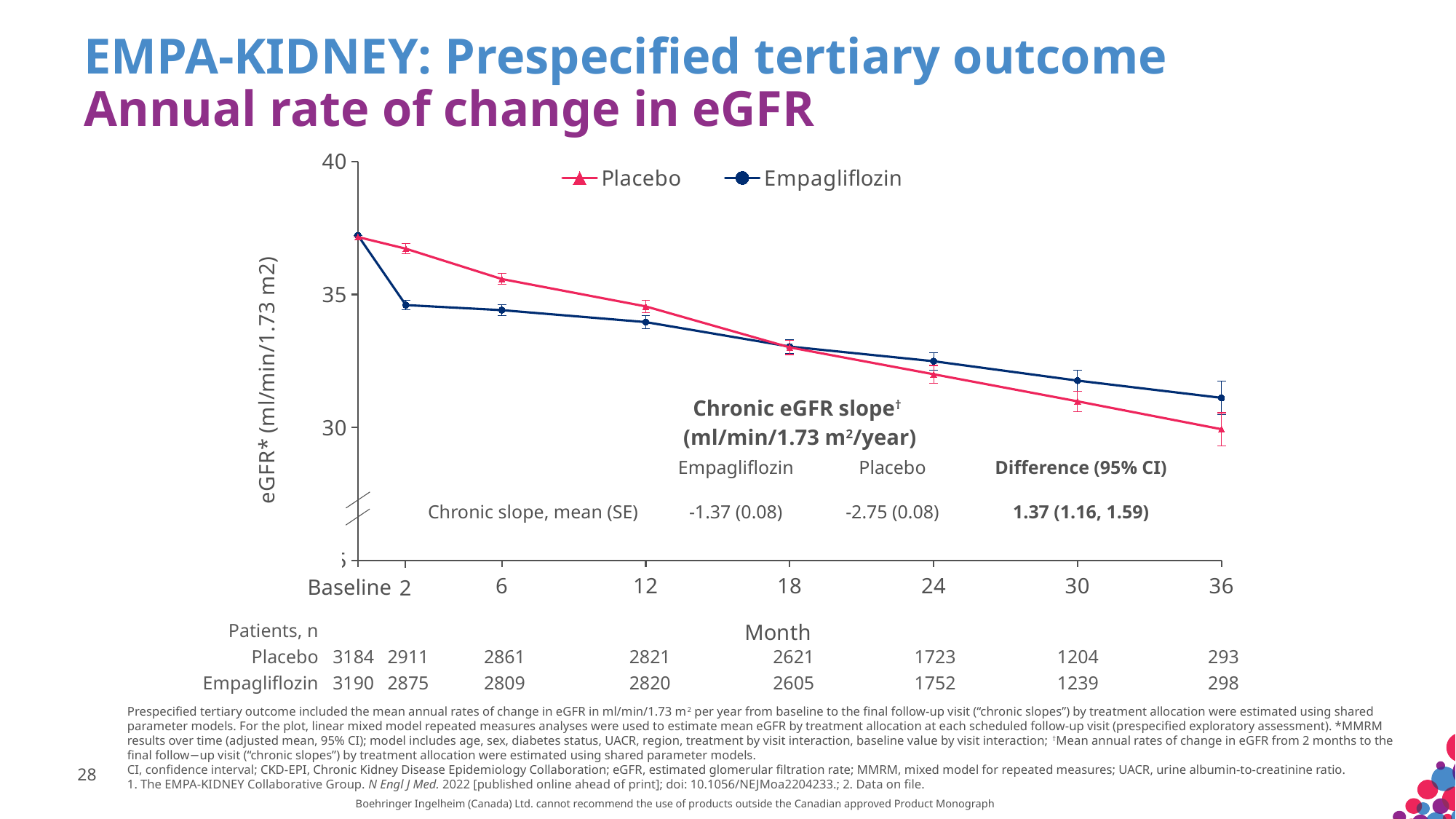
What is the chronic slope, mean (SE), shown for Empagliflozin? -1.37 (0.08) How many series does the legend list? 2 At which time point is the Empagliflozin eGFR value highest? Baseline At 36 months, which series has the higher eGFR value, Placebo or Empagliflozin? Empagliflozin Is the Placebo eGFR value at 2 months greater or less than 35? greater Is the Empagliflozin eGFR value at 36 months greater or less than 30? greater At 6 months, which series has the higher eGFR value, Placebo or Empagliflozin? Placebo How many time points are plotted along the x axis? 8 What marker shape does the legend use for the Placebo series? triangle What kind of chart is shown on the slide? line chart Is the Empagliflozin eGFR value at 12 months greater or less than 35? less Do the Placebo eGFR values rise or fall from Baseline to 36 months? fall